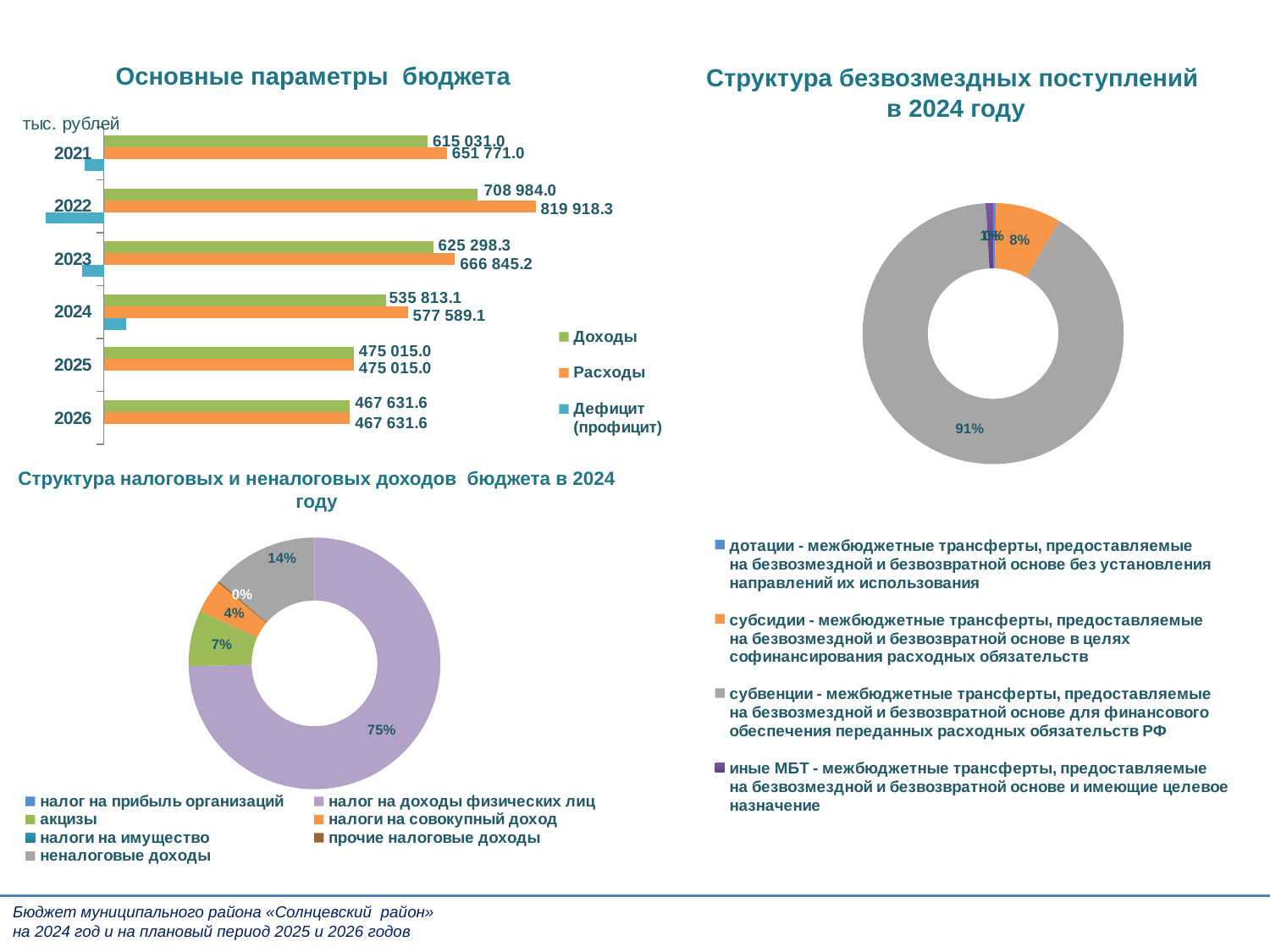
In the chart 'Основные параметры бюджета', do the Доходы values rise or fall from 2022 to 2026? Fall In the chart 'Основные параметры бюджета', what is the difference between Расходы and Доходы in 2021? 36 740.0 In the chart 'Основные параметры бюджета', what is the value of Расходы for 2024? 577 589.1 In the chart 'Основные параметры бюджета', which year has the highest Расходы? 2022 In the chart 'Основные параметры бюджета', how many series does the legend list? 3 In the chart 'Основные параметры бюджета', how many years are shown? 6 In the chart 'Основные параметры бюджета', which is larger in 2023: Доходы or Расходы? Расходы In the chart 'Структура налоговых и неналоговых доходов бюджета в 2024 году', what share does налог на доходы физических лиц have? 75% What type of chart is 'Основные параметры бюджета'? Bar chart In the chart 'Основные параметры бюджета', what is the value of Доходы for 2022? 708 984.0 In the chart 'Структура безвозмездных поступлений в 2024 году', what share do субвенции have? 91% In the chart 'Основные параметры бюджета', which year has the lowest Доходы? 2026